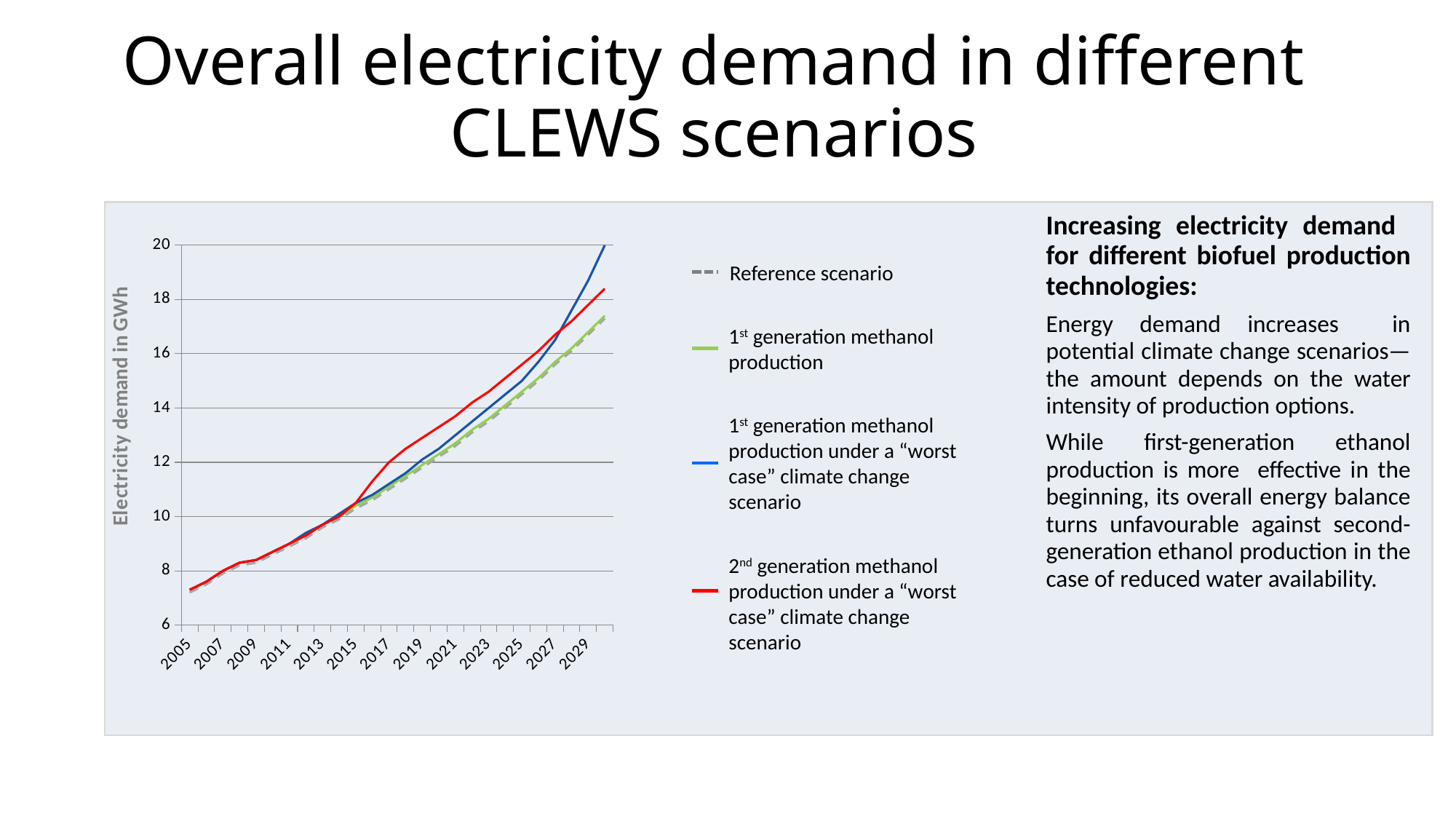
Is the value for the 2nd generation methanol production under a "worst case" climate change scenario in 2019 greater or less than 12? greater Is the value for the 1st generation methanol production series in 2029 greater or less than 18? less How many series does the legend list? 4 In 2029, which is larger: the 1st generation methanol production under a "worst case" climate change scenario or the 1st generation methanol production series? 1st generation methanol production under a "worst case" climate change scenario What kind of chart is shown on the slide? line chart Is the value for the Reference scenario in 2005 greater or less than 8? less What is the label of the vertical axis? Electricity demand in GWh Which series is drawn as a grey dashed line? Reference scenario Do the values for the Reference scenario rise or fall from 2005 to 2029? rise Which series has the highest value at the right end of the chart (2030)? 1st generation methanol production under a "worst case" climate change scenario In 2021, which is larger: the 2nd generation methanol production under a "worst case" climate change scenario or the 1st generation methanol production series? 2nd generation methanol production under a "worst case" climate change scenario